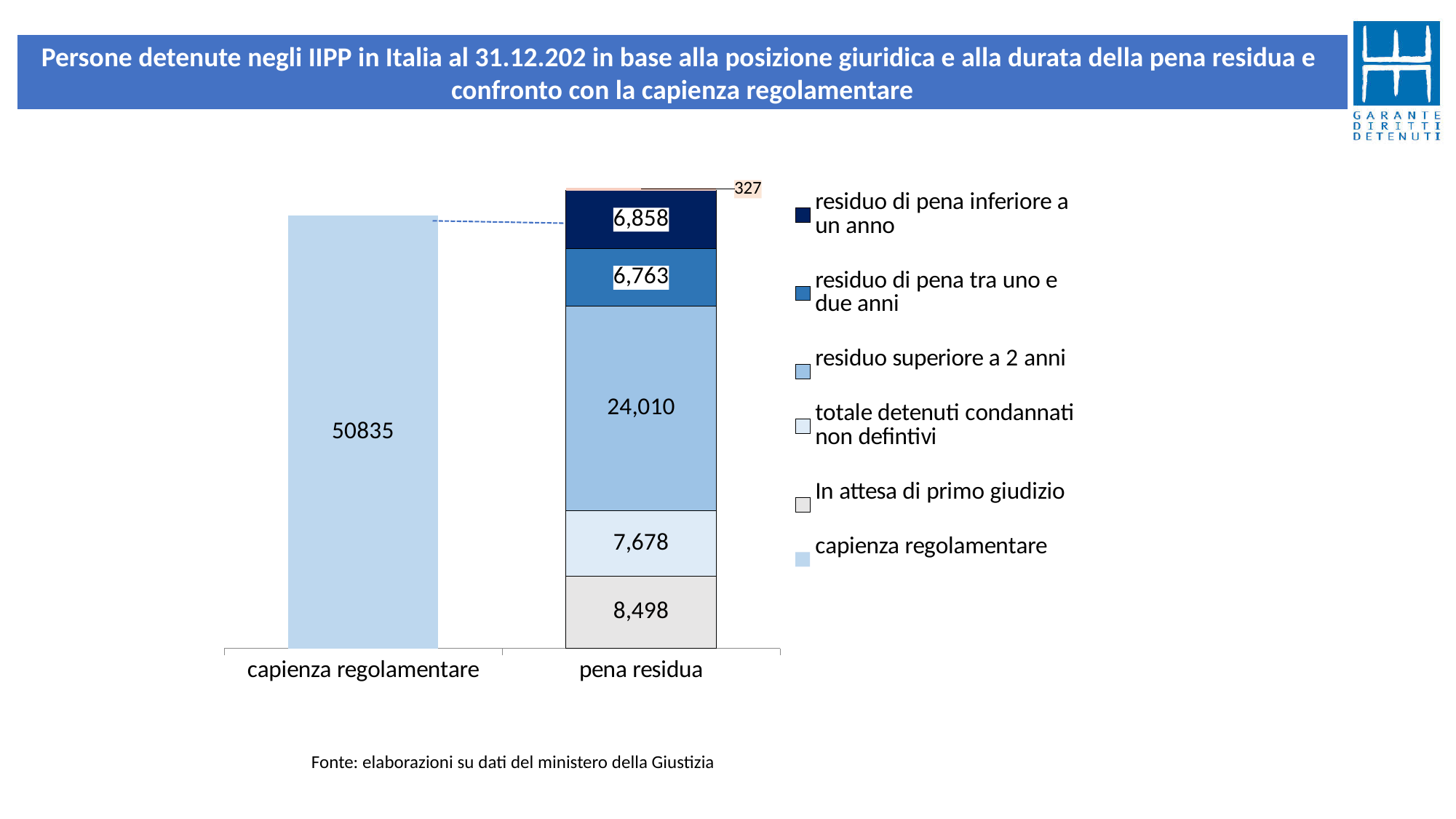
Which is larger: residuo di pena inferiore a un anno or residuo di pena tra uno e due anni? residuo di pena inferiore a un anno In the pena residua bar, what is the value for residuo di pena inferiore a un anno? 6,858 What kind of chart is shown on the slide? stacked bar chart What is the smallest value labeled on the pena residua bar? 327 How many entries does the legend list? 6 In the pena residua bar, what is the value for residuo superiore a 2 anni? 24,010 In the pena residua bar, what is the value for In attesa di primo giudizio? 8,498 In the pena residua bar, what is the value for totale detenuti condannati non definitivi? 7,678 What is the difference between residuo superiore a 2 anni (24,010) and In attesa di primo giudizio (8,498)? 15,512 What is the value shown for capienza regolamentare? 50835 How many categories are shown on the x axis? 2 Which segment of the pena residua bar has the largest value? residuo superiore a 2 anni